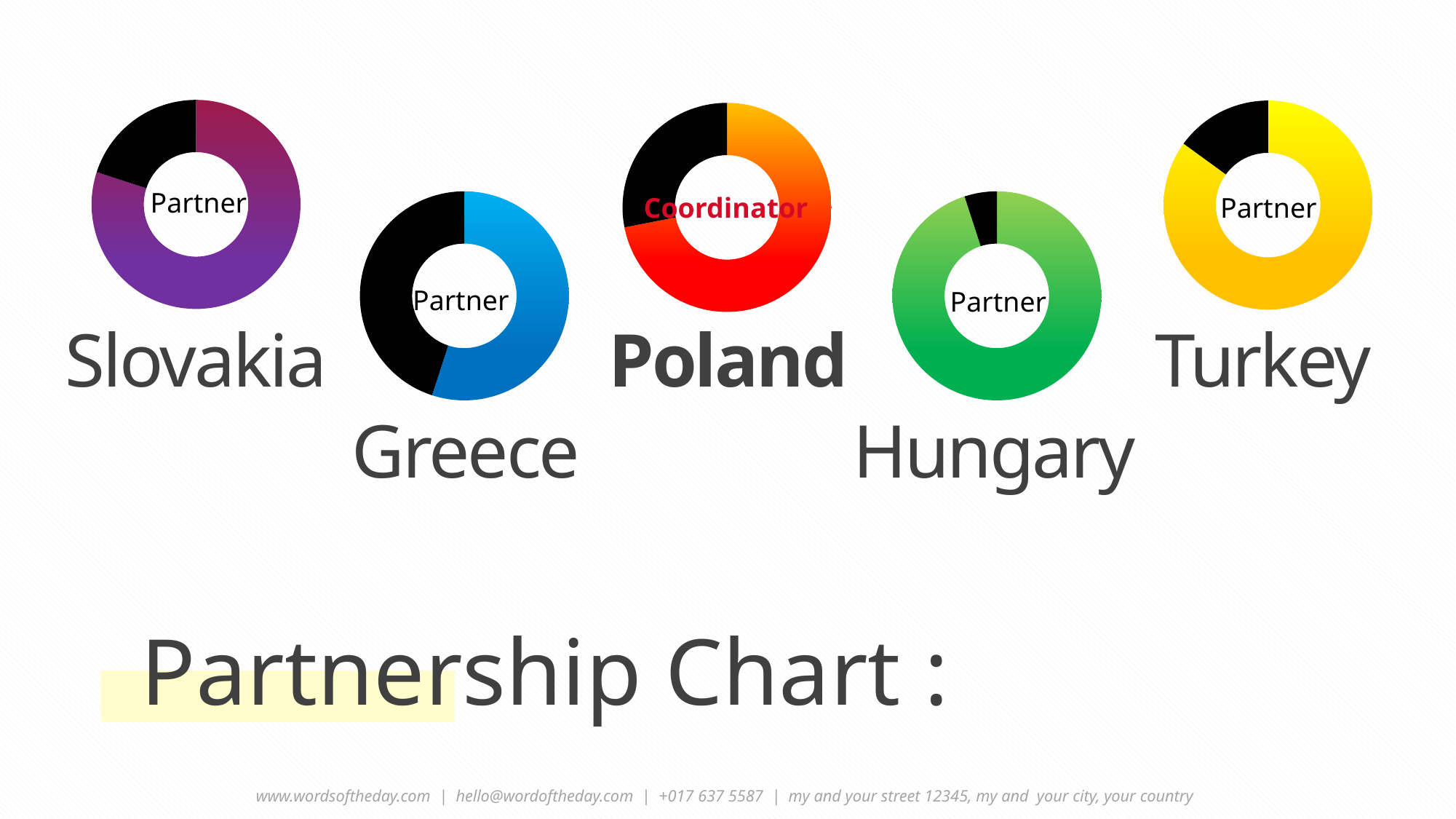
How many slices does the Hungary doughnut chart have? 2 Which country's chart has the largest black slice? Greece In the Slovakia chart, which slice is larger, the purple slice or the black slice? Purple In the Hungary chart, which slice is larger, the green slice or the black slice? Green What label appears in the centre of the Slovakia chart? Partner What kind of chart is used for each country on the slide? Doughnut chart Which country's chart is labelled "Coordinator" in its centre? Poland What is the title text at the bottom of the slide? Partnership Chart : Which country's chart has the smallest black slice? Hungary How many doughnut charts are shown on the slide? 5 In the Turkey chart, which slice is larger, the yellow slice or the black slice? Yellow What colour is the non-black slice of the Greece chart? Blue